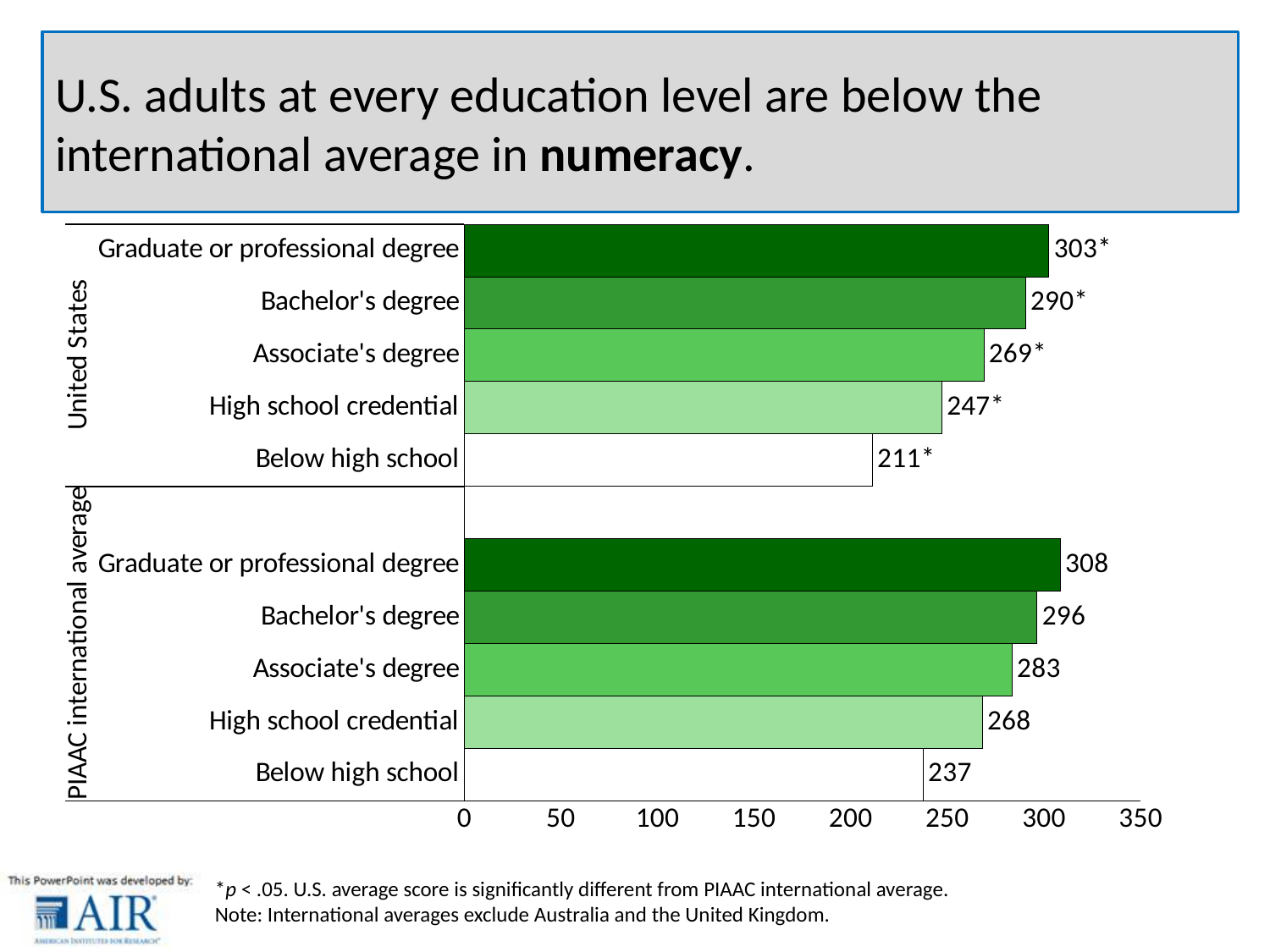
What kind of chart is shown on the slide? Bar chart Which bar in the chart has the highest value? PIAAC international average, Graduate or professional degree What is the difference between the PIAAC international average and the U.S. score for adults with an associate's degree? 14 What is the PIAAC international average numeracy score for adults with a bachelor's degree? 296 What is the numeracy score for U.S. adults with a graduate or professional degree? 303* What is the PIAAC international average numeracy score for adults below high school? 237 Which bar in the chart has the lowest value? United States, Below high school How many bars are plotted in the chart? 10 Which is larger: the U.S. score for a bachelor's degree or the PIAAC international average score for an associate's degree? U.S. score for a bachelor's degree What is the difference between the PIAAC international average and the U.S. score for adults below high school? 26 What is the maximum value shown on the horizontal axis of the chart? 350 What is the numeracy score for U.S. adults with a high school credential? 247*